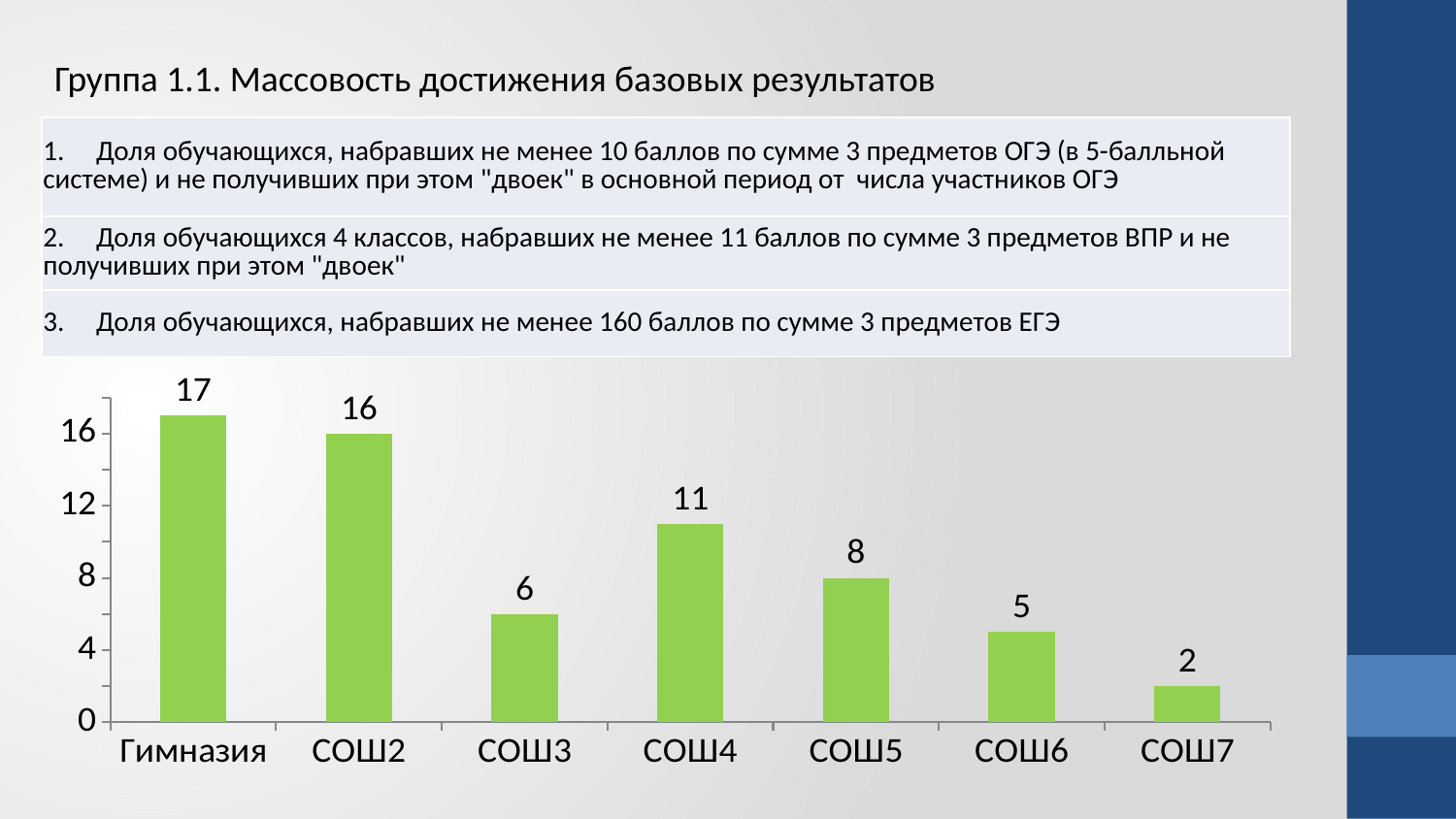
What is the value for Гимназия? 17 What kind of chart is shown on the slide? bar chart What is the value for СОШ4? 11 What is the difference between the values for Гимназия and СОШ2? 1 What colour are the bars in the chart? green Which category has the highest value? Гимназия What is the value for СОШ7? 2 Which is larger, the value for СОШ5 or the value for СОШ6? СОШ5 Which category has the lowest value? СОШ7 What is the difference between the values for СОШ4 and СОШ3? 5 Is the value for СОШ3 greater or less than 8? less How many categories are shown on the x axis? 7